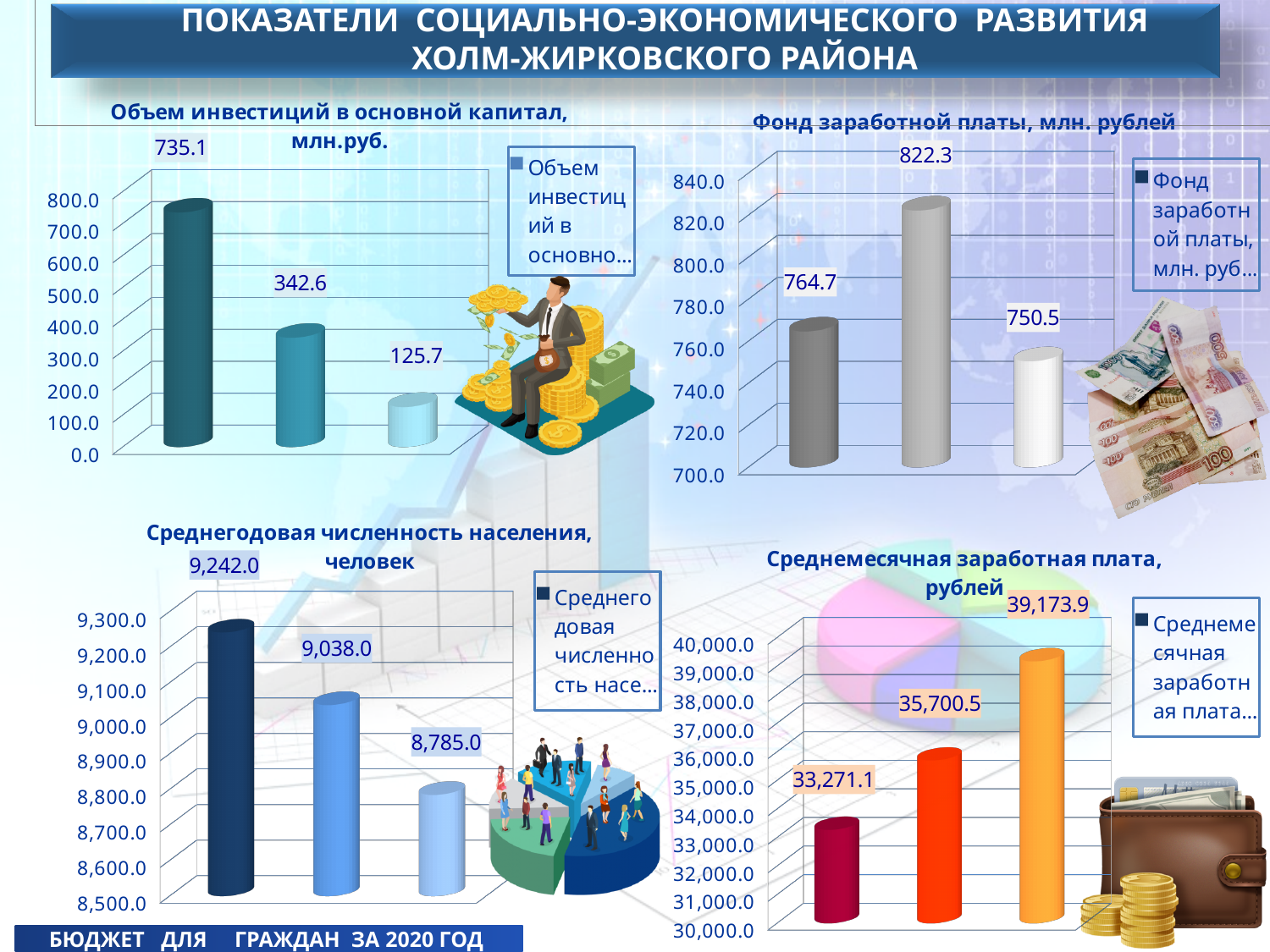
What type of chart is 'Среднемесячная заработная плата, рублей'? bar chart In the chart 'Объем инвестиций в основной капитал, млн.руб.', what is the value of the first (tallest) bar? 735.1 In the chart 'Фонд заработной платы, млн. рублей', what is the difference between the second bar (822.3) and the first bar (764.7)? 57.6 In the chart 'Фонд заработной платы, млн. рублей', what is the highest value shown? 822.3 In the chart 'Объем инвестиций в основной капитал, млн.руб.', do the values rise or fall from left to right? fall In the chart 'Среднегодовая численность населения, человек', what is the value of the second bar? 9,038.0 In the chart 'Среднемесячная заработная плата, рублей', what is the value of the first bar? 33,271.1 In the chart 'Объем инвестиций в основной капитал, млн.руб.', what is the value of the third bar? 125.7 In the chart 'Среднегодовая численность населения, человек', how many bars are plotted? 3 In the chart 'Среднемесячная заработная плата, рублей', do the values rise or fall from left to right? rise In the chart 'Фонд заработной платы, млн. рублей', what is the lowest value shown? 750.5 In the chart 'Среднегодовая численность населения, человек', which is larger: the first bar or the third bar? the first bar (9,242.0)